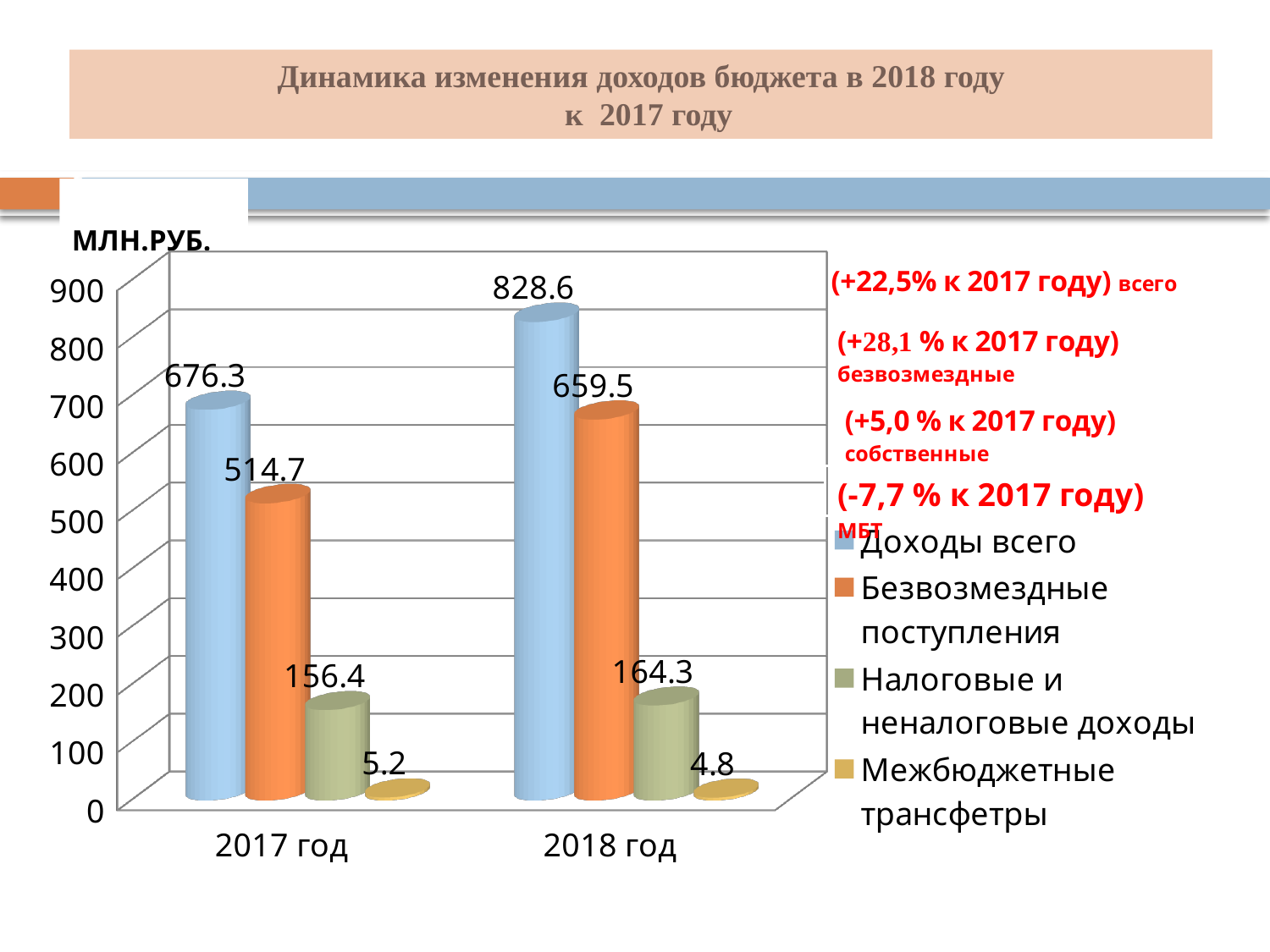
How many series does the legend list? 4 Which series has the highest value in 2017 год? Доходы всего What is the value of Доходы всего for 2018 год? 828.6 Which year has the higher value for Доходы всего? 2018 год What is the difference between Безвозмездные поступления in 2018 год and 2017 год? 144.8 What is the value of Межбюджетные трансфетры for 2017 год? 5.2 What is the difference between Доходы всего in 2018 год and 2017 год? 152.3 What kind of chart is shown on the slide? Bar chart What is the value of Налоговые и неналоговые доходы for 2018 год? 164.3 How many year categories are shown on the x axis? 2 Which series has the lowest value in 2018 год? Межбюджетные трансфетры What is the value of Безвозмездные поступления for 2017 год? 514.7